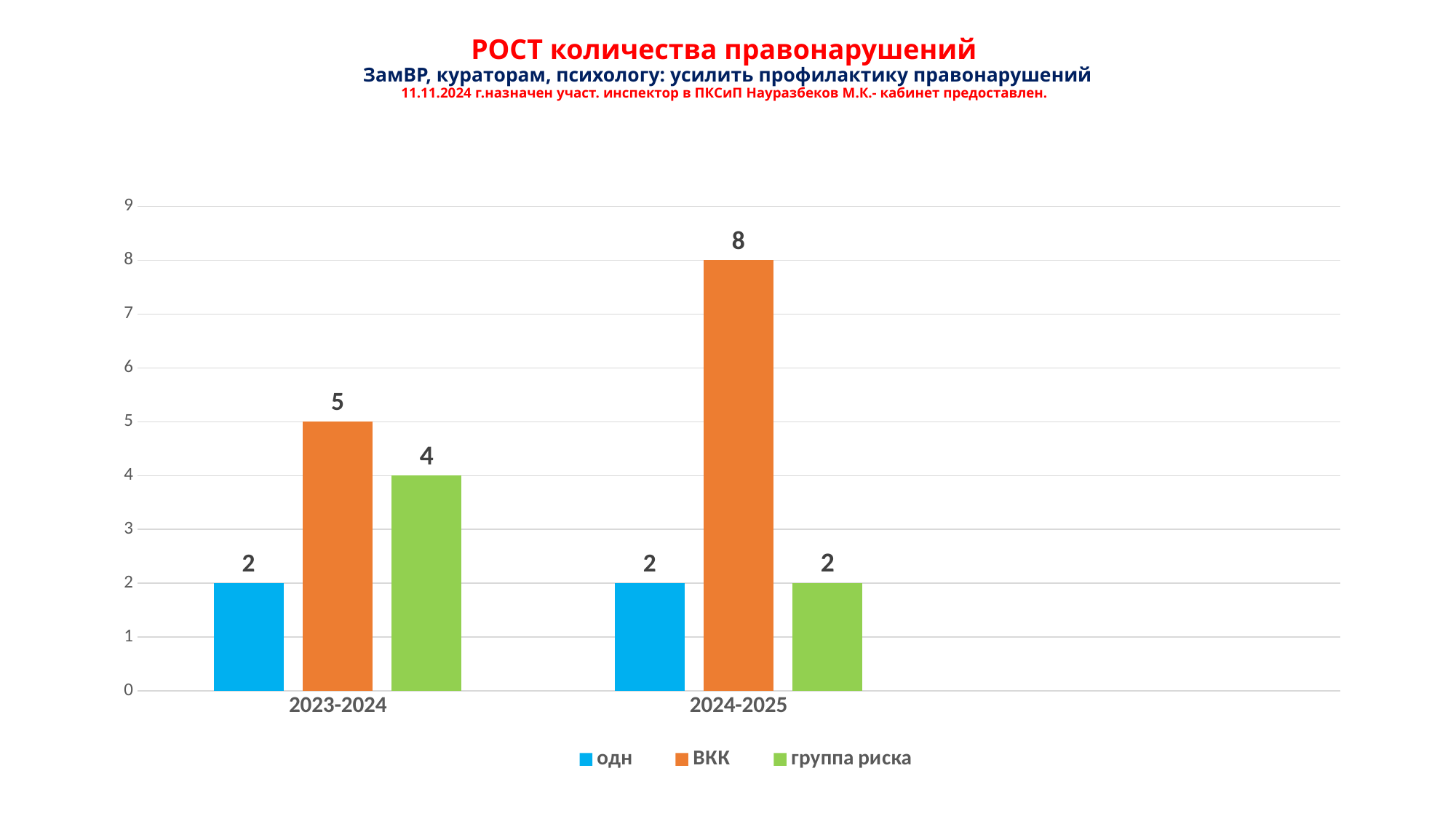
How many categories are shown on the x axis? 2 What kind of chart is shown on the slide? bar chart What is the value for одн in 2023-2024? 2 Which series has the lowest value in 2023-2024? одн What is the value for ВКК in 2023-2024? 5 How many series does the legend list? 3 What is the difference between the ВКК values for 2024-2025 and 2023-2024? 3 Which is larger: группа риска in 2023-2024 or группа риска in 2024-2025? 2023-2024 What is the value for ВКК in 2024-2025? 8 What is the value for группа риска in 2023-2024? 4 Does the value for ВКК rise or fall from 2023-2024 to 2024-2025? rise Which series has the highest value in 2024-2025? ВКК